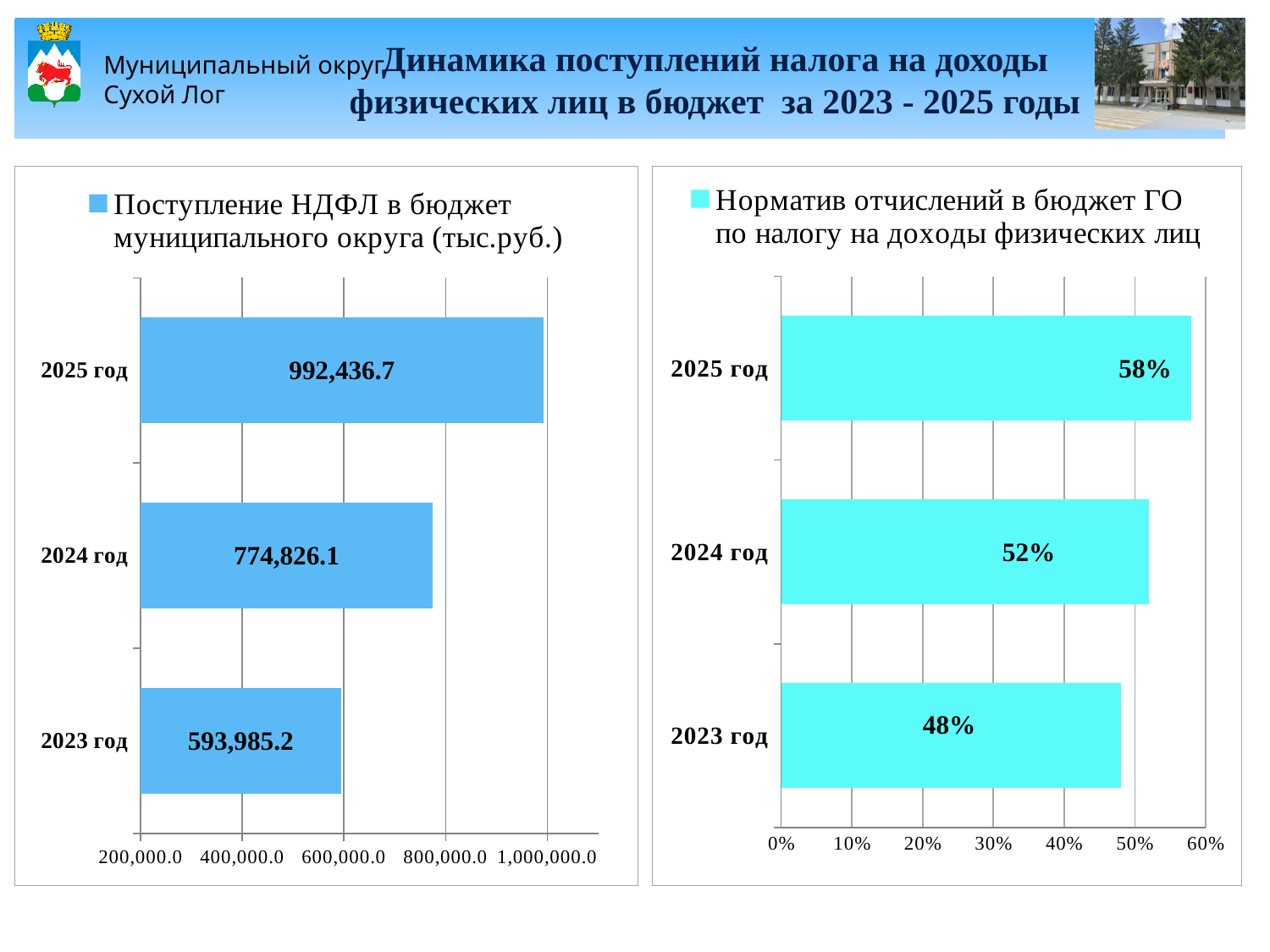
What kind of chart is the right chart (Норматив отчислений в бюджет ГО)? bar chart In the left chart (Поступление НДФЛ в бюджет муниципального округа), what is the value for 2023 год? 593,985.2 In the right chart (Норматив отчислений в бюджет ГО), is the value for 2023 год greater or less than 50%? less In the left chart (Поступление НДФЛ в бюджет муниципального округа), which is larger: the value for 2024 год or 2023 год? 2024 год In the left chart (Поступление НДФЛ в бюджет муниципального округа), what is the value for 2025 год? 992,436.7 In the left chart (Поступление НДФЛ в бюджет муниципального округа), what is the difference between the values for 2025 год and 2024 год? 217,610.6 In the left chart (Поступление НДФЛ в бюджет муниципального округа), which year has the lowest value? 2023 год In the right chart (Норматив отчислений в бюджет ГО), what is the difference between the values for 2025 год and 2023 год? 10% How many years are shown in the left chart (Поступление НДФЛ в бюджет муниципального округа)? 3 In the right chart (Норматив отчислений в бюджет ГО), do the values rise or fall from 2023 год to 2025 год? rise In the right chart (Норматив отчислений в бюджет ГО), what is the value for 2024 год? 52% In the right chart (Норматив отчислений в бюджет ГО), which year has the highest value? 2025 год